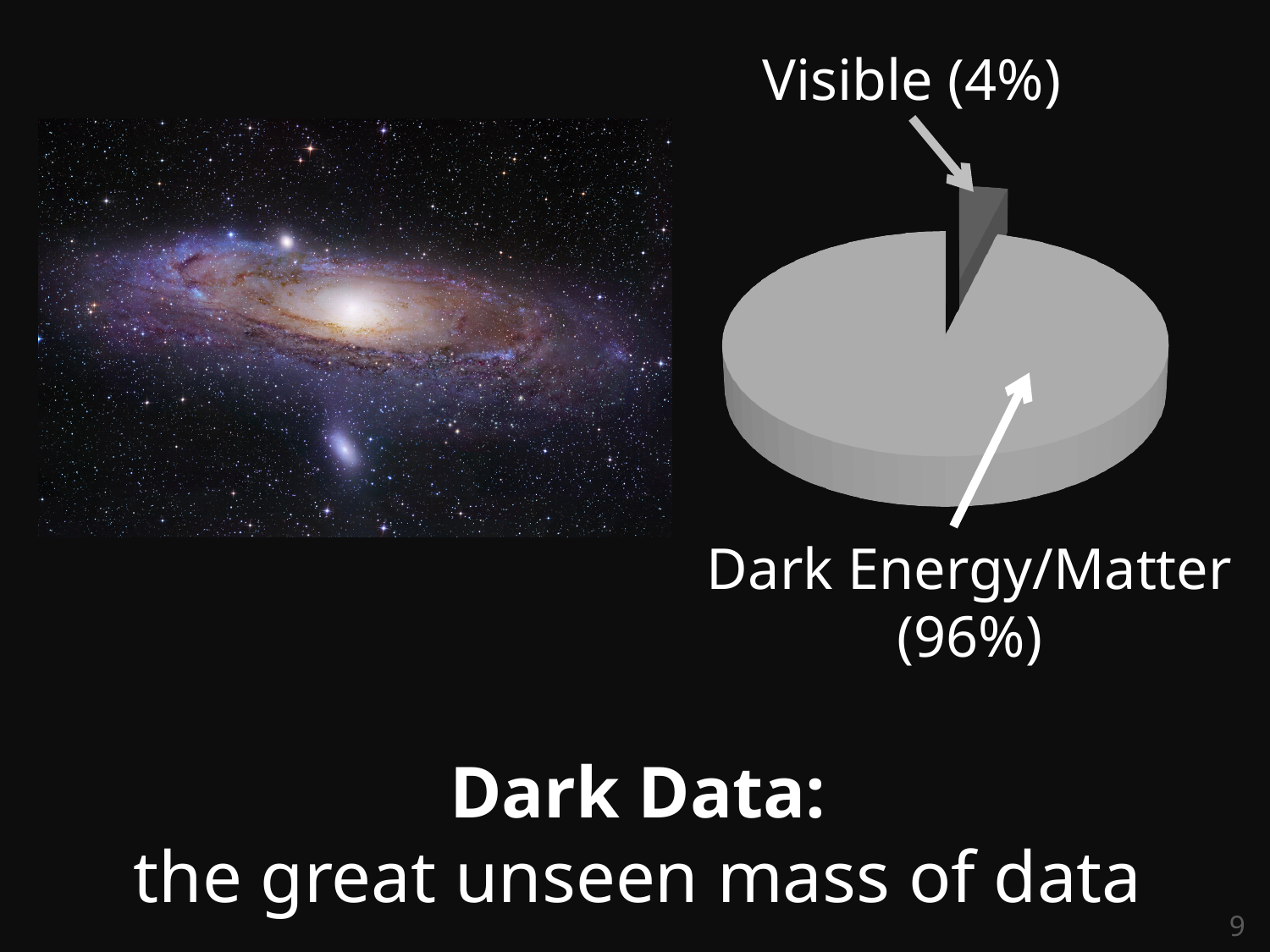
How many slices does the pie chart have? 2 What share of the pie chart is labelled Dark Energy/Matter? 96% Which is larger, the Visible slice or the Dark Energy/Matter slice? Dark Energy/Matter What is the bold heading text below the chart? Dark Data: What is the difference in percentage points between the Dark Energy/Matter slice and the Visible slice? 92 Which slice of the pie chart is pulled out (exploded) from the rest? Visible Which slice of the pie chart is the largest? Dark Energy/Matter Which slice of the pie chart is the smallest? Visible What share of the pie chart is labelled Visible? 4% Is the Visible slice greater or less than 10% of the pie? less What kind of chart is shown on the slide? Pie chart